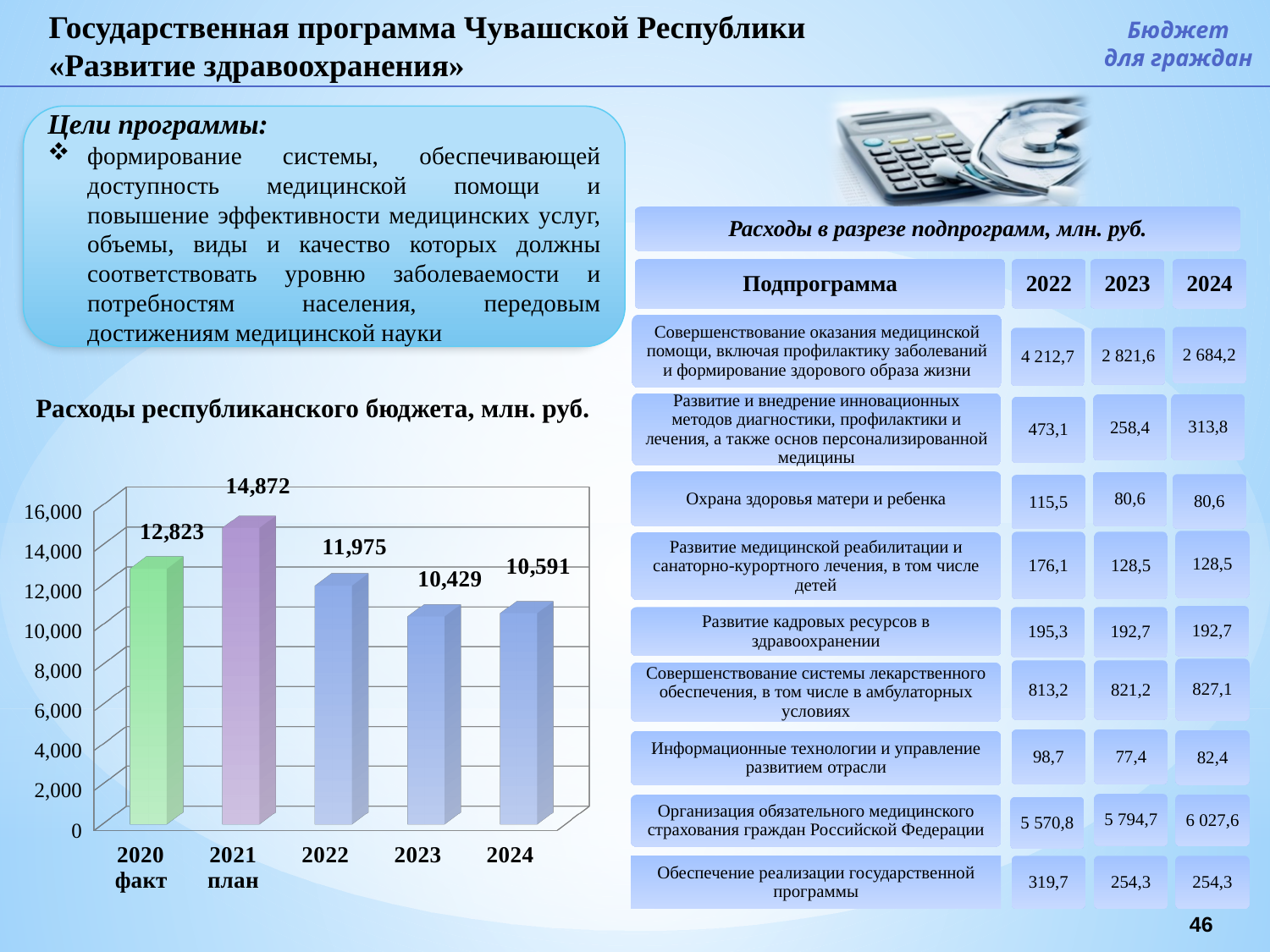
What is the difference between the values for 2024 and 2023? 162 What is the value for 2020 факт in the chart? 12,823 How many bars are shown in the chart? 5 What type of chart is shown on the slide? bar chart What is the value for 2021 план in the chart? 14,872 Which is larger, the value for 2020 факт or the value for 2022? 2020 факт What is the value for 2023 in the chart? 10,429 What is the title of the chart? Расходы республиканского бюджета, млн. руб. What is the difference between the values for 2021 план and 2022? 2,897 Is the value for 2022 greater or less than 10,000? greater Which year has the lowest value in the chart? 2023 Which year has the highest value in the chart? 2021 план